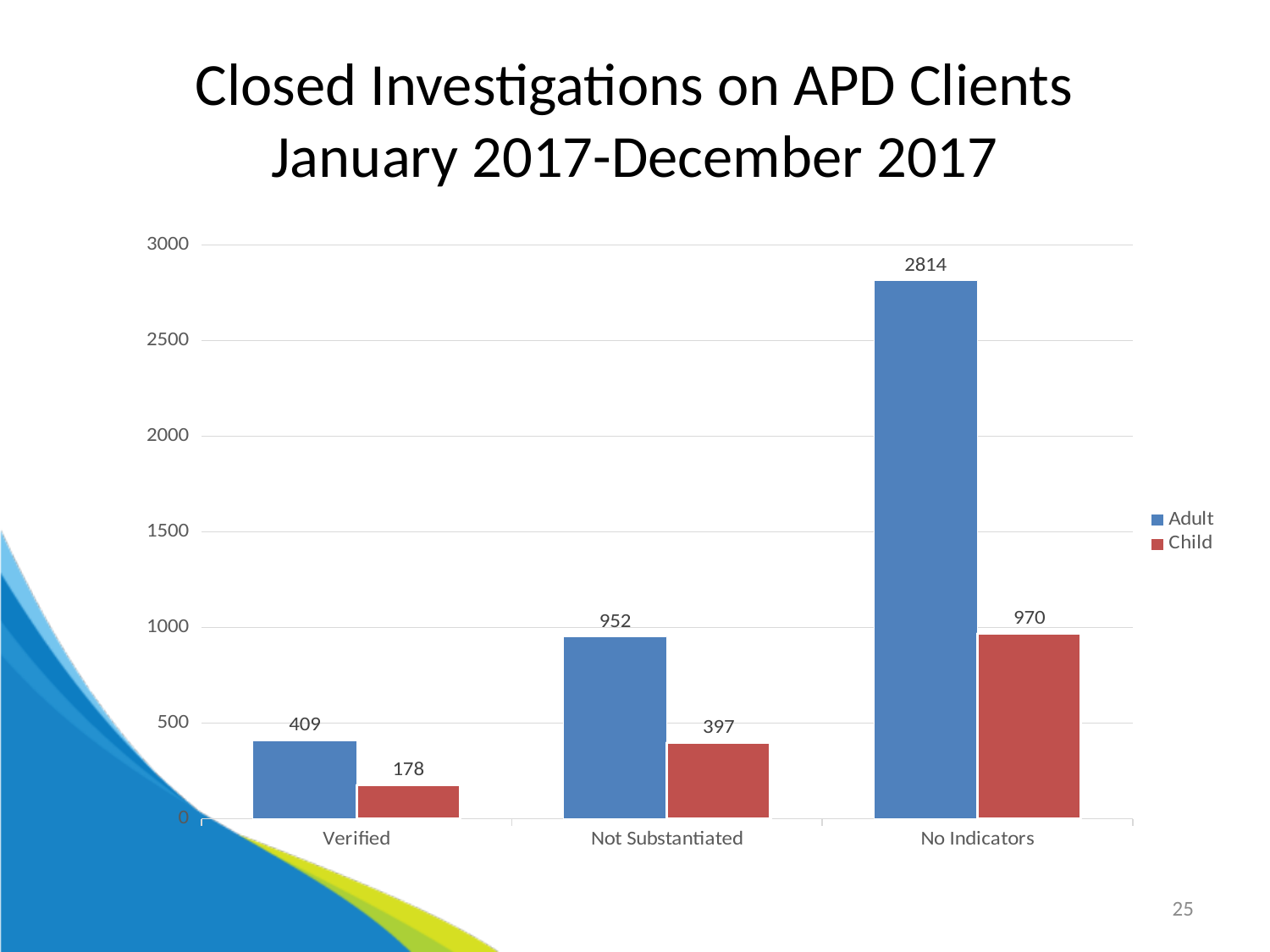
What kind of chart is shown on the slide? Bar chart Which is larger: the Child value for No Indicators or the Adult value for Not Substantiated? Child value for No Indicators Do the Adult values rise or fall from Verified to No Indicators? Rise What is the Child value for No Indicators? 970 How many categories are shown on the x axis? 3 Which category has the highest Adult value? No Indicators What is the Adult value for Verified? 409 Which category has the lowest Child value? Verified How many series does the legend list? 2 What is the difference between the Adult values for Not Substantiated and Verified? 543 What is the Child value for Not Substantiated? 397 What is the difference between the Adult and Child values for No Indicators? 1844